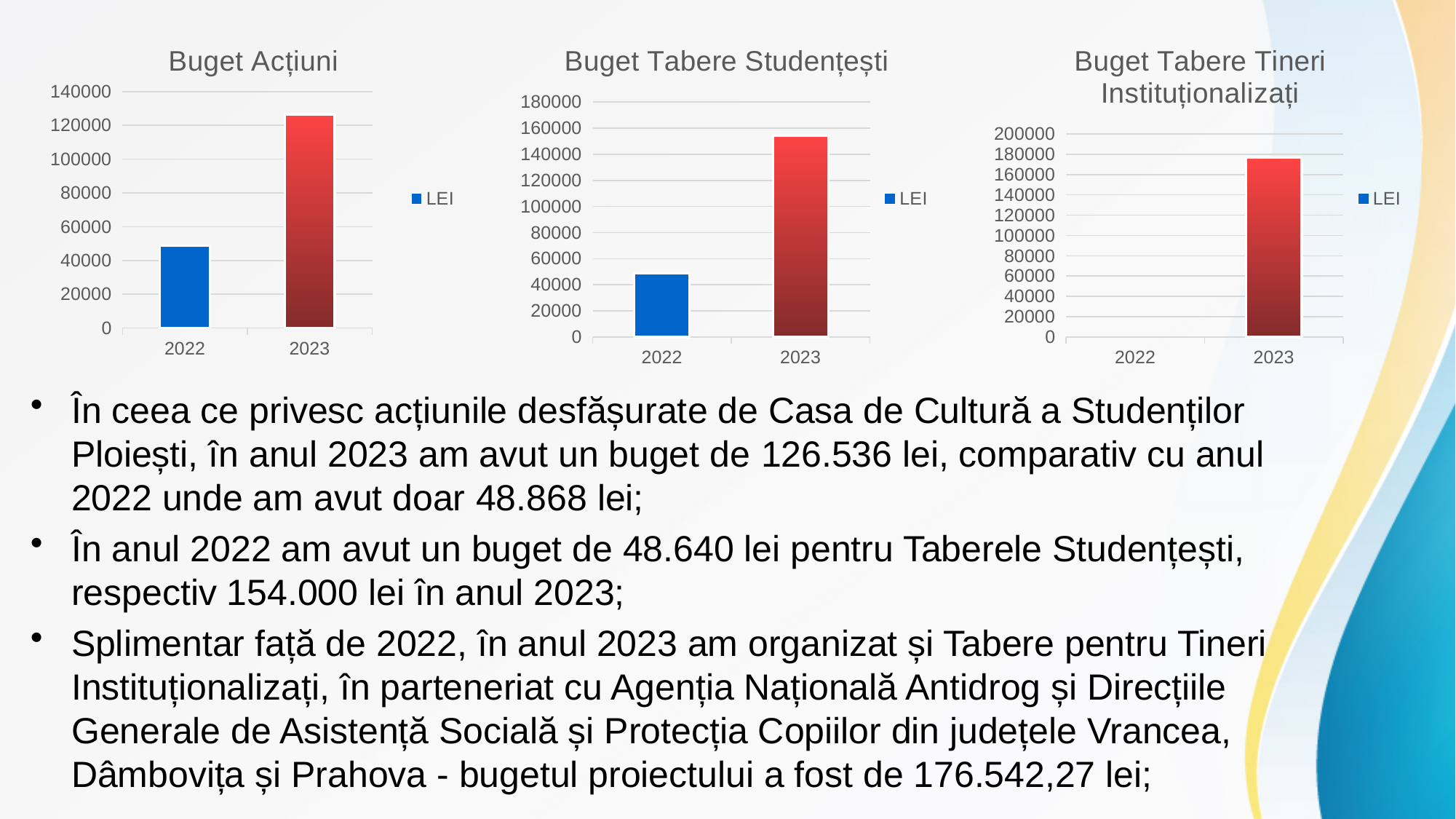
In the Buget Tabere Studențești chart, how many series does the legend list? 1 In the Buget Acțiuni chart, is the value for 2022 greater or less than 60000? less In the Buget Acțiuni chart, how many years are shown on the x axis? 2 In the Buget Tabere Studențești chart, is the value for 2023 greater or less than 140000? greater In the Buget Tabere Tineri Instituționalizați chart, is the value for 2023 greater or less than 160000? greater In the Buget Acțiuni chart, what kind of chart is shown? bar chart In the Buget Acțiuni chart, which year has the higher value? 2023 In the Buget Tabere Tineri Instituționalizați chart, which year has the lowest value? 2022 In the Buget Tabere Studențești chart, do the values rise or fall from 2022 to 2023? rise In the Buget Acțiuni chart, what is the name of the series in the legend? LEI